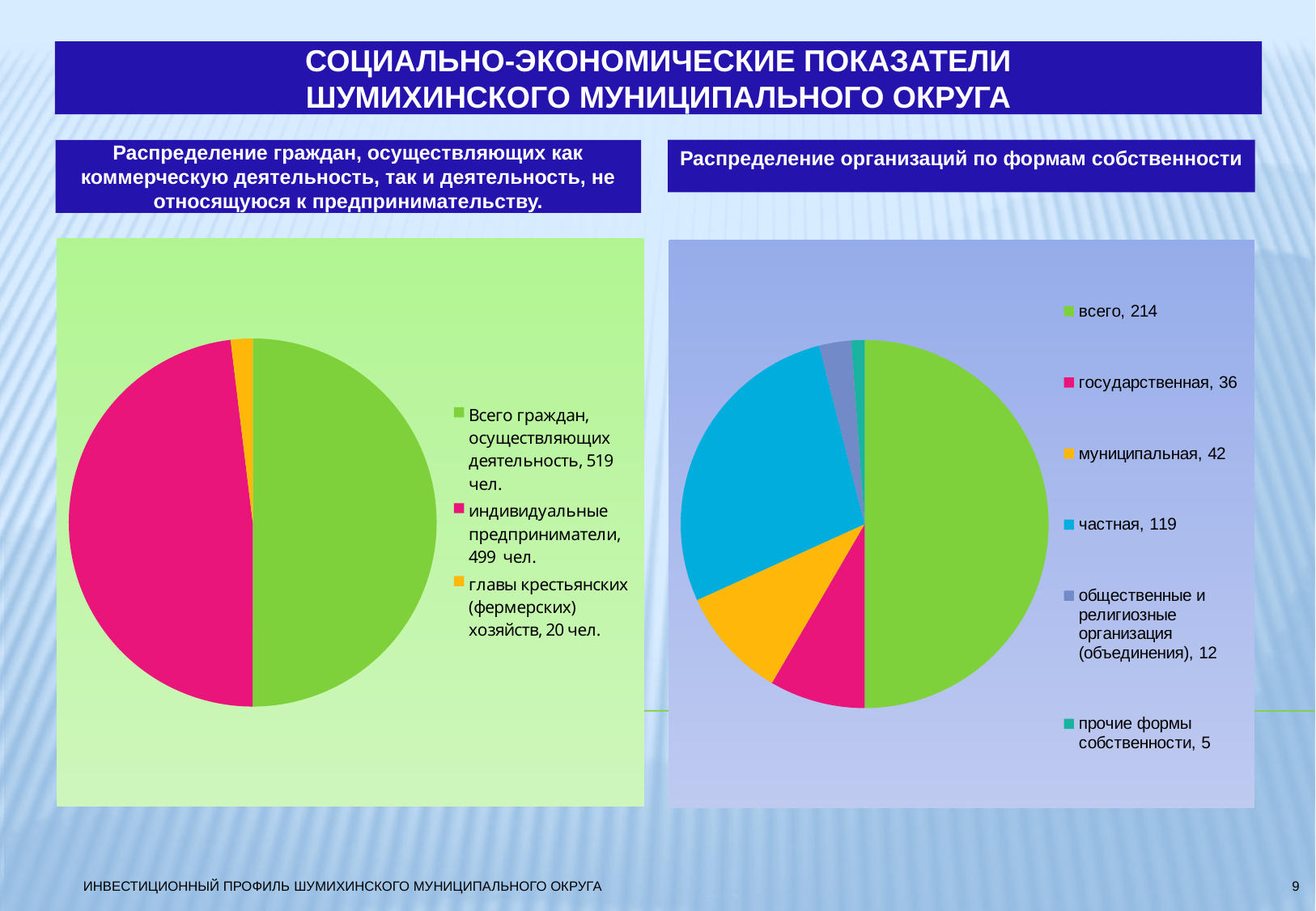
On the left chart, what is the value for 'Всего граждан, осуществляющих деятельность'? 519 чел. On the left chart, how many people are listed for 'индивидуальные предприниматели'? 499 чел. On the right chart, which form of ownership has the smallest value? прочие формы собственности What type of chart is used on the left chart, 'Распределение граждан, осуществляющих как коммерческую деятельность, так и деятельность, не относящуюся к предпринимательству'? Pie chart On the right chart, which is larger: 'государственная' or 'муниципальная'? муниципальная On the left chart, what is the difference between 'индивидуальные предприниматели' (499) and 'главы крестьянских (фермерских) хозяйств' (20)? 479 On the left chart, what is the value for 'главы крестьянских (фермерских) хозяйств'? 20 чел. On the right chart, 'Распределение организаций по формам собственности', what is the value for 'частная'? 119 On the left chart, how many entries does the legend list? 3 On the right chart, how many entries does the legend list? 6 On the right chart, what is the difference between 'частная' (119) and 'государственная' (36)? 83 On the right chart, what is the value for 'муниципальная'? 42